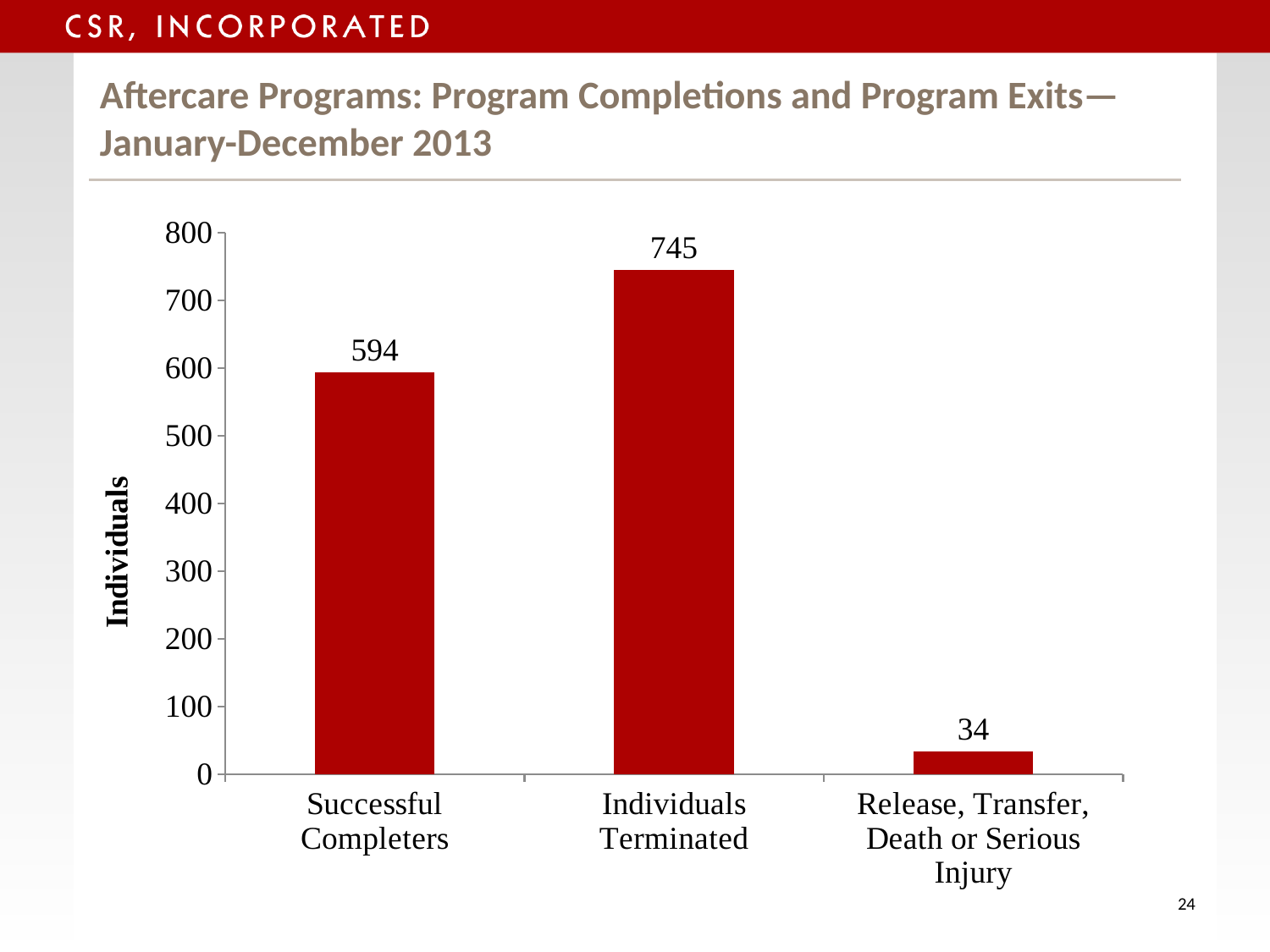
What is the value for Successful Completers? 594 What is the label of the vertical axis? Individuals Which is larger, Successful Completers or Individuals Terminated? Individuals Terminated What is the difference between Individuals Terminated and Successful Completers? 151 What is the value for Individuals Terminated? 745 What is the value for Release, Transfer, Death or Serious Injury? 34 Which category has the highest value? Individuals Terminated How many categories are shown on the x axis? 3 Is the value for Successful Completers greater or less than 500? greater What kind of chart is shown on the slide? bar chart Which category has the lowest value? Release, Transfer, Death or Serious Injury What is the difference between Successful Completers and Release, Transfer, Death or Serious Injury? 560